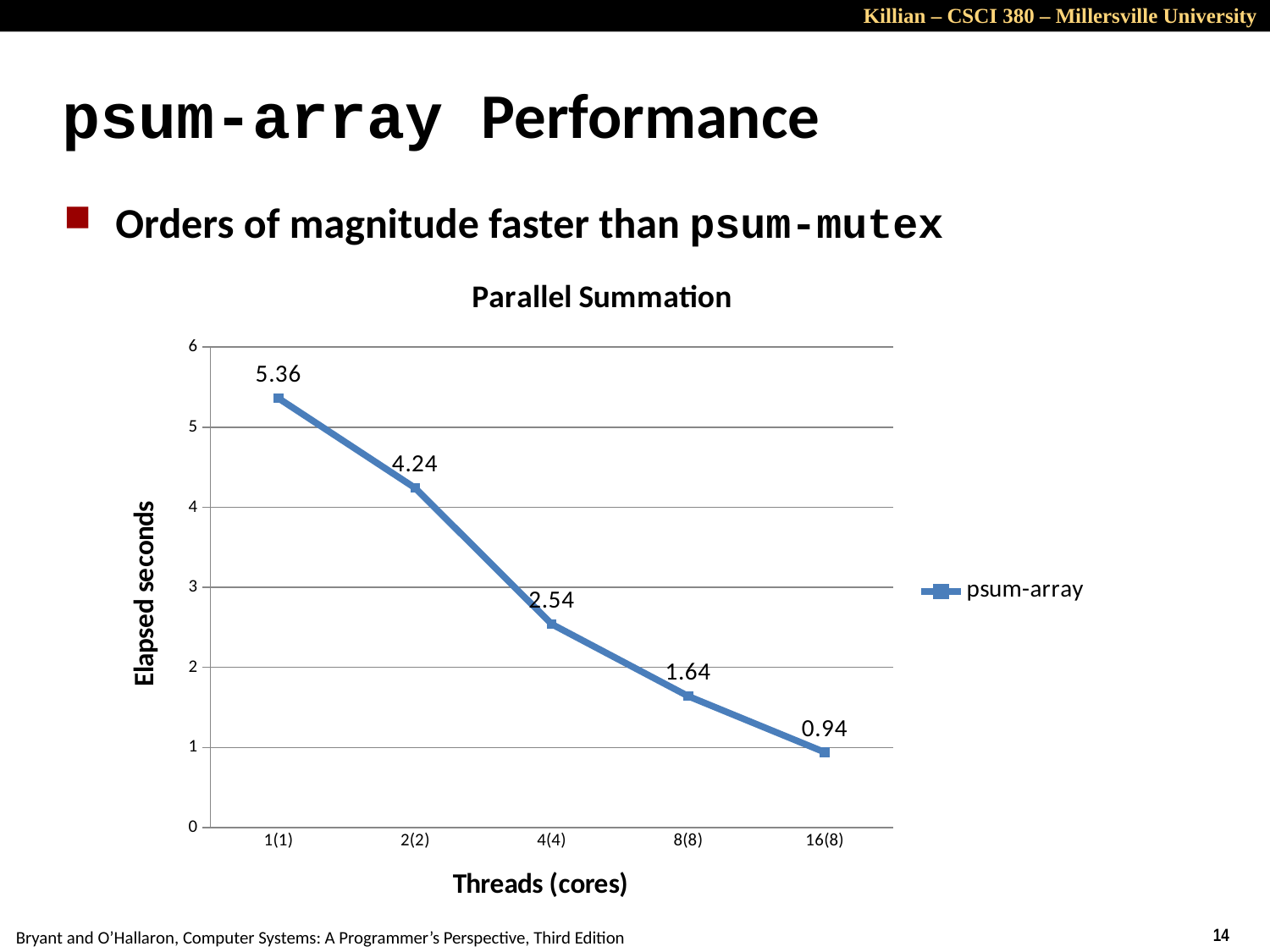
Which has a larger elapsed seconds value, 2(2) or 4(4) threads? 2(2) Which threads (cores) category has the highest elapsed seconds? 1(1) How many series does the legend list? 1 Which threads (cores) category has the lowest elapsed seconds? 16(8) What is the elapsed seconds value for 1(1) threads (cores)? 5.36 How many data points are plotted on the chart? 5 Do the elapsed seconds rise or fall as the number of threads increases along the x axis? fall What is the difference in elapsed seconds between 2(2) and 8(8) threads? 2.6 Is the value for 8(8) threads greater or less than 2? less What is the elapsed seconds value for 16(8) threads (cores)? 0.94 What is the elapsed seconds value for 4(4) threads (cores)? 2.54 What kind of chart is shown on the slide? line chart